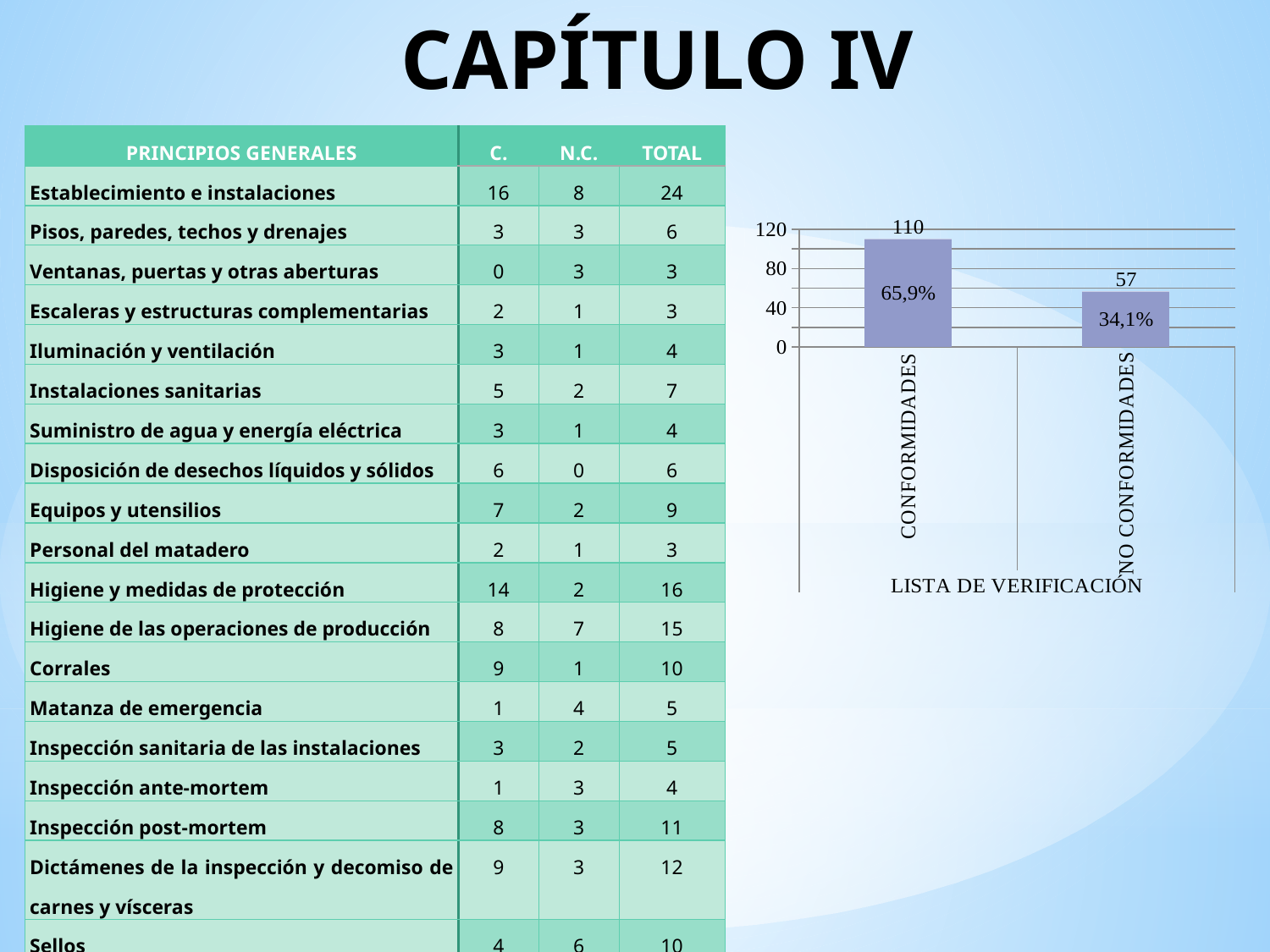
What is the value for NO CONFORMIDADES in the chart? 57 What type of chart is shown on the slide? bar chart Which is larger, the value for CONFORMIDADES or the value for NO CONFORMIDADES? CONFORMIDADES Which category has the highest value in the chart? CONFORMIDADES What is the title of the horizontal axis of the chart? LISTA DE VERIFICACIÓN What percentage is shown on the NO CONFORMIDADES bar? 34,1% What percentage is shown on the CONFORMIDADES bar? 65,9% What is the value for CONFORMIDADES in the chart? 110 How many categories are plotted in the chart? 2 Which category has the lowest value in the chart? NO CONFORMIDADES What is the difference between the values for CONFORMIDADES and NO CONFORMIDADES? 53 Is the value for NO CONFORMIDADES greater or less than 80? less